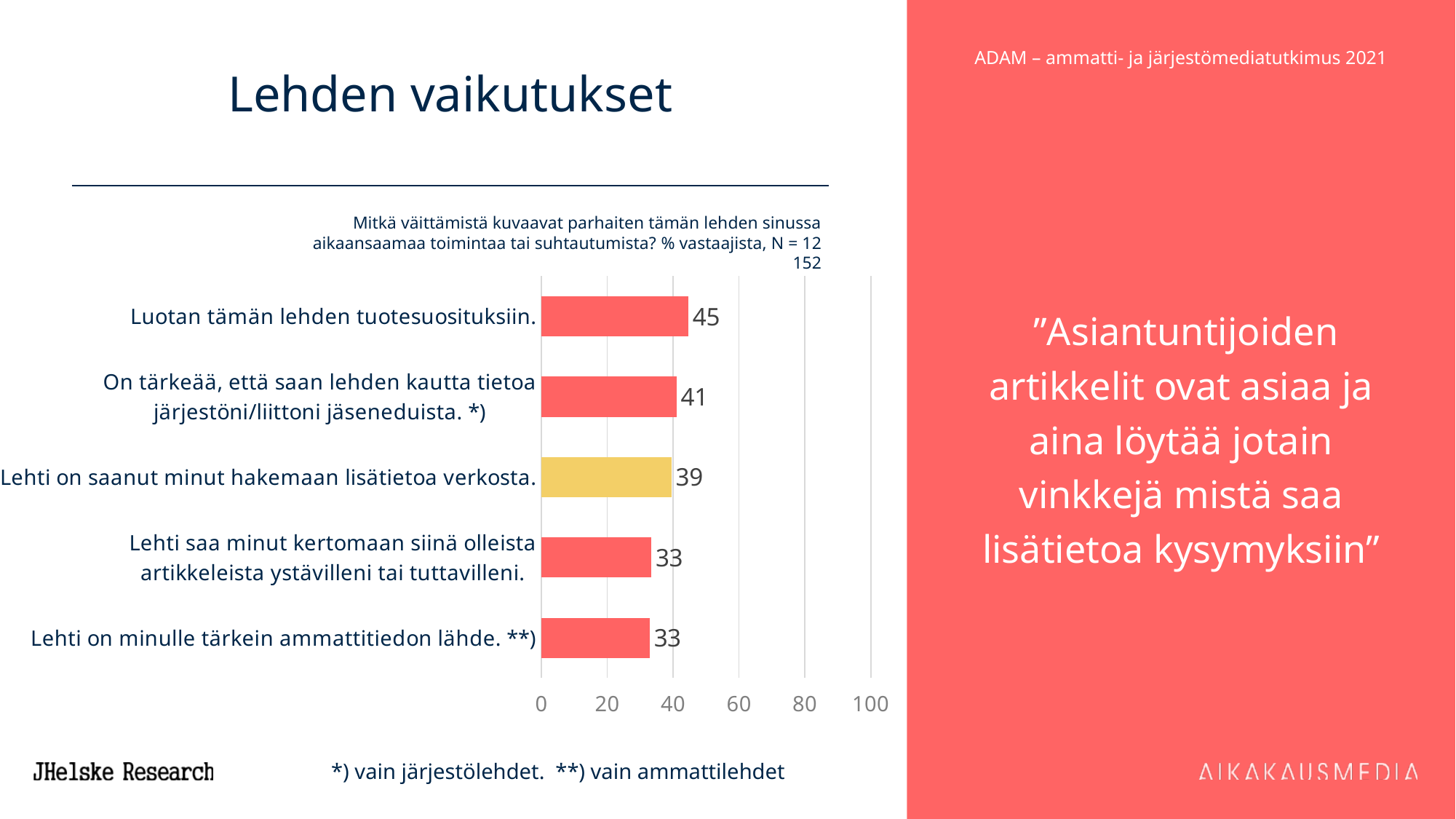
What is the value for "Lehti saa minut kertomaan siinä olleista artikkeleista ystävilleni tai tuttavilleni."? 33 How many categories are shown in the chart? 5 What is the value for "Luotan tämän lehden tuotesuosituksiin."? 45 Which bar is coloured differently (yellow) from the others? Lehti on saanut minut hakemaan lisätietoa verkosta. Is the value for "Luotan tämän lehden tuotesuosituksiin." greater or less than 40? greater What is the difference between the values for "Luotan tämän lehden tuotesuosituksiin." and "Lehti on minulle tärkein ammattitiedon lähde. **)"? 12 What is the value for "On tärkeää, että saan lehden kautta tietoa järjestöni/liittoni jäseneduista. *)"? 41 Which is larger: the value for "On tärkeää, että saan lehden kautta tietoa järjestöni/liittoni jäseneduista. *)" or the value for "Lehti on saanut minut hakemaan lisätietoa verkosta."? On tärkeää, että saan lehden kautta tietoa järjestöni/liittoni jäseneduista. *) Which category has the highest value? Luotan tämän lehden tuotesuosituksiin. What kind of chart is shown on the slide? bar chart What is the value for "Lehti on saanut minut hakemaan lisätietoa verkosta."? 39 What is the title of the slide containing the chart? Lehden vaikutukset